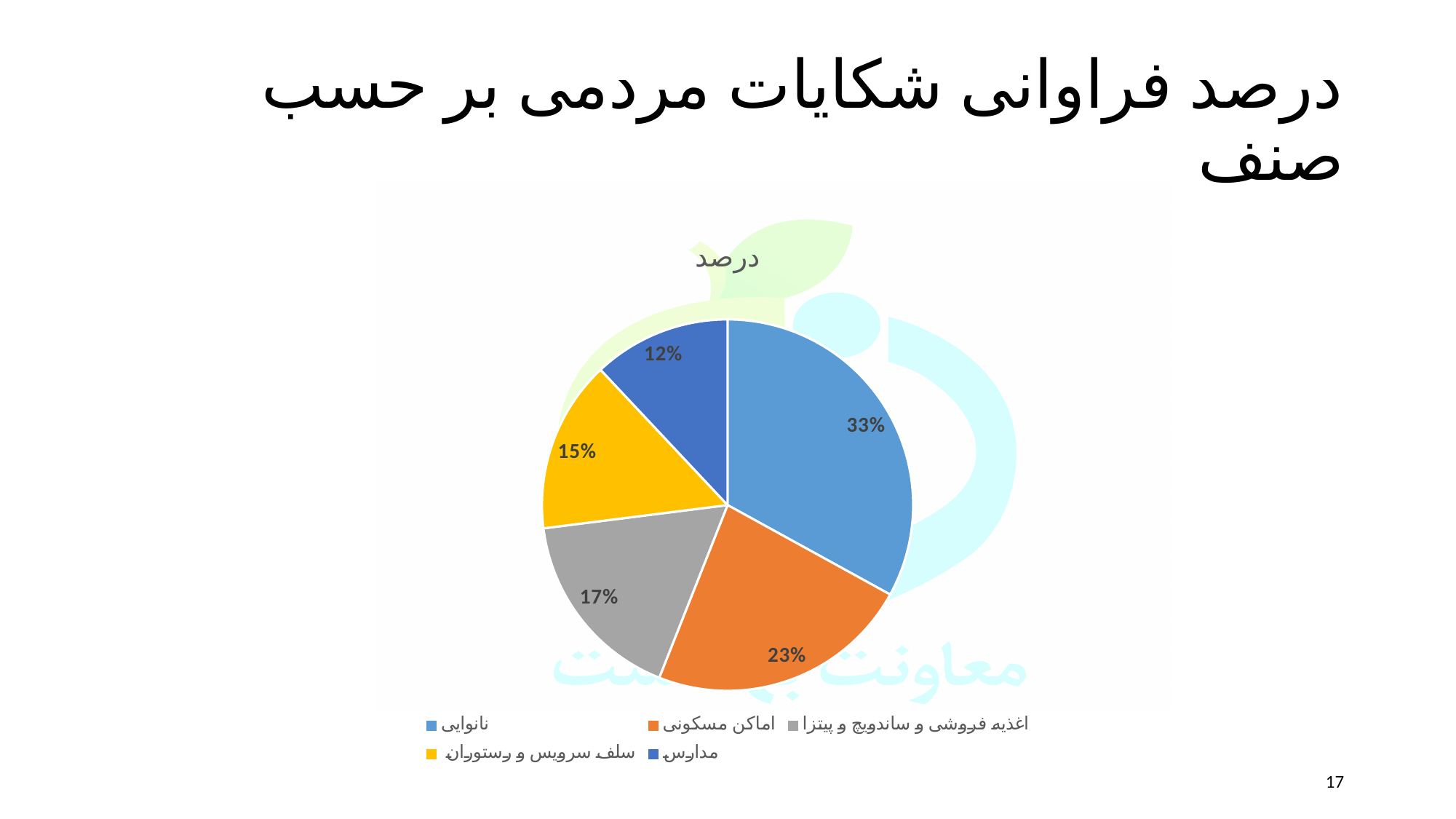
What percentage is shown for اغذیه فروشی و ساندویچ و پیتزا? 17% What is the difference in percentage points between نانوایی and اماکن مسکونی? 10 How many entries does the legend list? 5 Which category has the largest share of the pie? نانوایی How many slices does the pie chart have? 5 What percentage is shown for نانوایی? 33% What percentage is shown for سلف سرویس و رستوران? 15% Which category has the smallest share of the pie? مدارس What percentage is shown for مدارس? 12% What percentage is shown for اماکن مسکونی? 23% What kind of chart is shown on the slide? Pie chart What is the chart's title? درصد